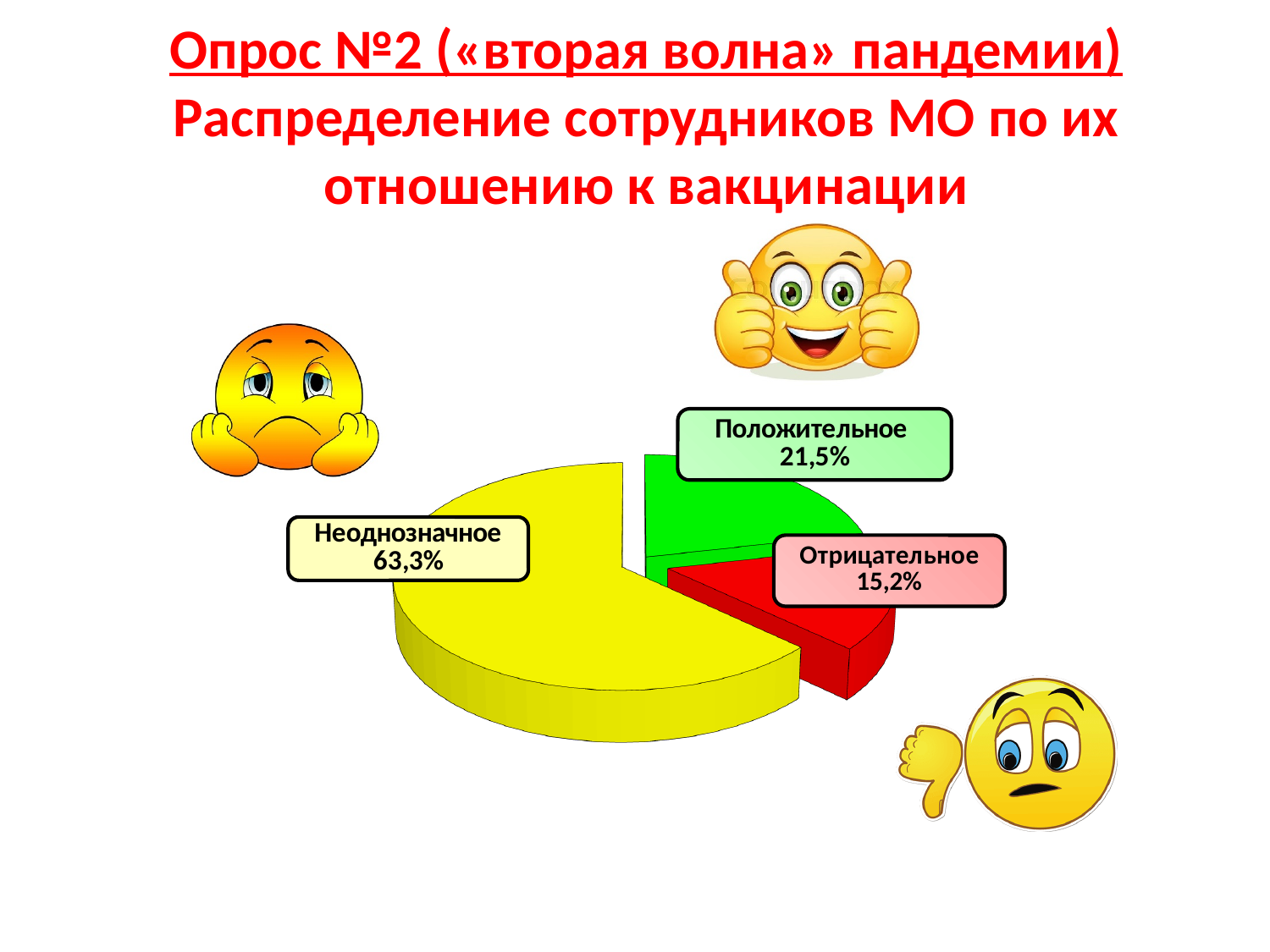
Which is larger, the Положительное slice or the Отрицательное slice? Положительное What kind of chart is shown on the slide? Pie chart What is the difference in percentage points between the Положительное and Отрицательное slices? 6,3 What colour is the Отрицательное slice? Red What share of the pie is labelled Неоднозначное? 63,3% What is the difference in percentage points between the Неоднозначное and Положительное slices? 41,8 Which category has the smallest slice of the pie? Отрицательное What colour is the Положительное slice? Green Which category has the largest slice of the pie? Неоднозначное What share of the pie is labelled Положительное? 21,5% How many slices does the pie chart have? 3 What share of the pie is labelled Отрицательное? 15,2%